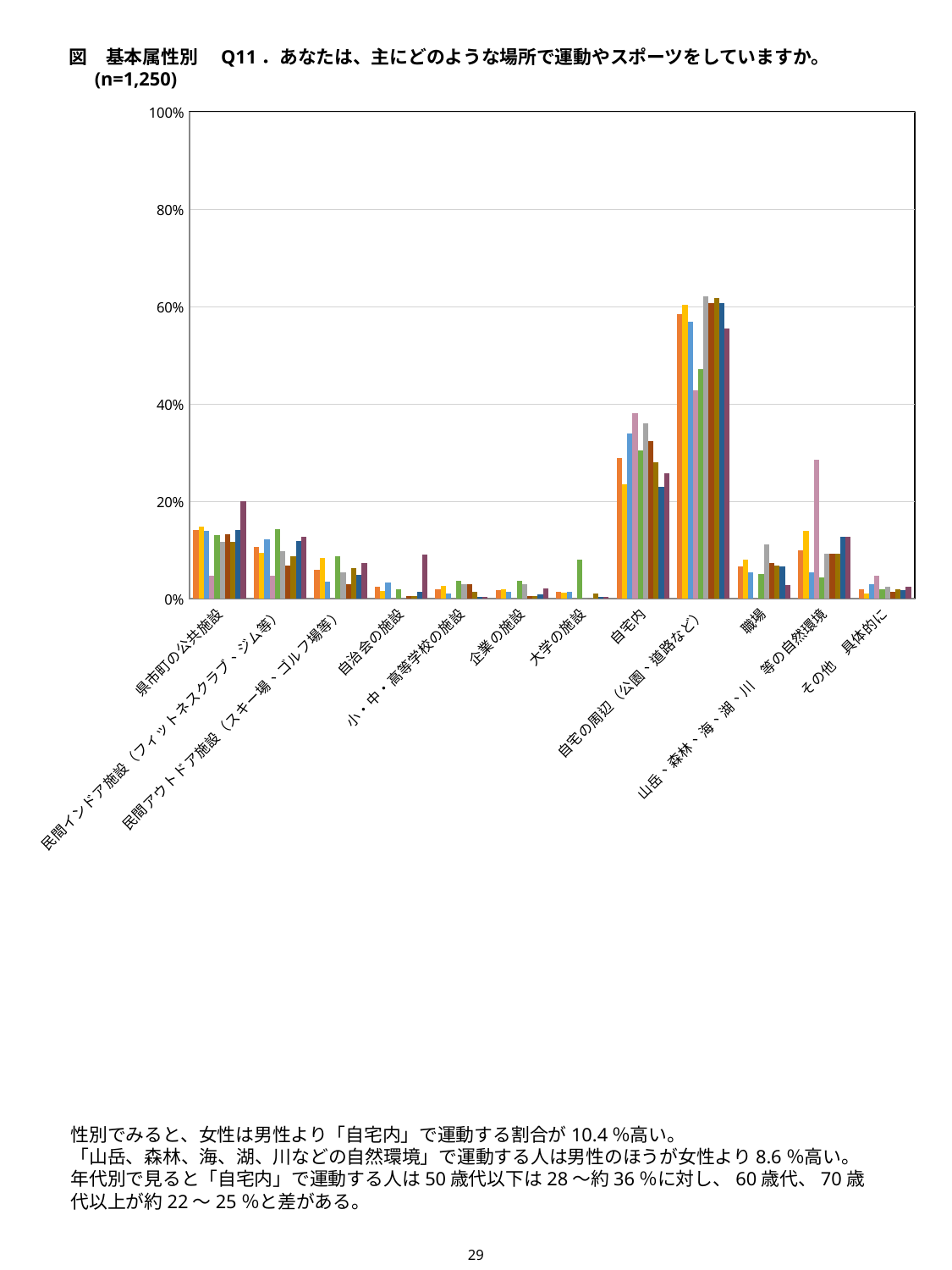
Which category has the tallest bars in the chart? 自宅の周辺（公園・道路など） What is the maximum value shown on the y axis of the chart? 100% Is the tallest bar for 企業の施設 greater or less than 20%? less Which category has taller bars overall, 自宅内 or 自宅の周辺（公園・道路など）? 自宅の周辺（公園・道路など） How many categories (places) are shown along the x axis of the chart? 12 What kind of chart is shown on the slide? bar chart Is the tallest bar for 自宅内 greater or less than 20%? greater Is the tallest bar for 職場 greater or less than 20%? less Which category has taller bars overall, 自宅内 or 職場? 自宅内 What is the sample size (n) stated in the chart title? n=1,250